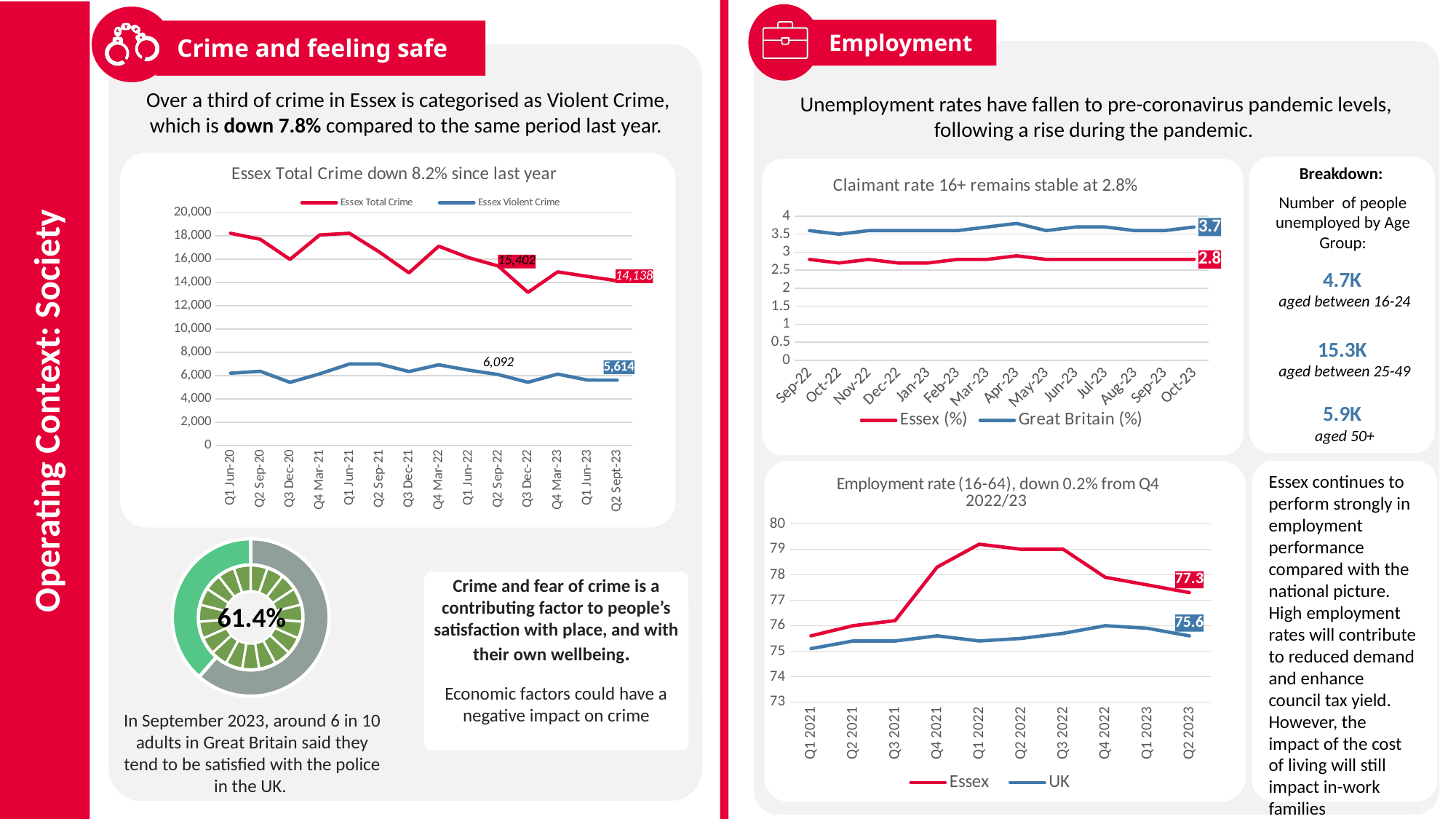
In the 'Essex Total Crime down 8.2% since last year' chart, what is the value of Essex Total Crime at Q2 Sept-23? 14,138 In the 'Essex Total Crime down 8.2% since last year' chart, is the value of Essex Total Crime at Q3 Dec-22 greater or less than 14,000? less What kind of chart is the 'Claimant rate 16+ remains stable at 2.8%' chart? line chart How many quarterly points are plotted along the x axis of the 'Essex Total Crime down 8.2% since last year' chart? 14 In the 'Essex Total Crime down 8.2% since last year' chart, what is the labelled value of Essex Total Crime at Q2 Sep-22? 15,402 In the 'Essex Total Crime down 8.2% since last year' chart, what is the difference between the labelled Essex Violent Crime values at Q2 Sep-22 (6,092) and Q2 Sept-23 (5,614)? 478 In the 'Employment rate (16-64), down 0.2% from Q4 2022/23' chart, what is the difference between the Essex and UK values at Q2 2023? 1.7 In the 'Claimant rate 16+ remains stable at 2.8%' chart, what is the Great Britain (%) value at Oct-23? 3.7 In the 'Employment rate (16-64), down 0.2% from Q4 2022/23' chart, which is higher at Q2 2023, Essex or UK? Essex In the 'Essex Total Crime down 8.2% since last year' chart, what is the value of Essex Violent Crime at Q2 Sept-23? 5,614 In the 'Claimant rate 16+ remains stable at 2.8%' chart, what is the difference between the Great Britain (%) and Essex (%) values at Oct-23? 0.9